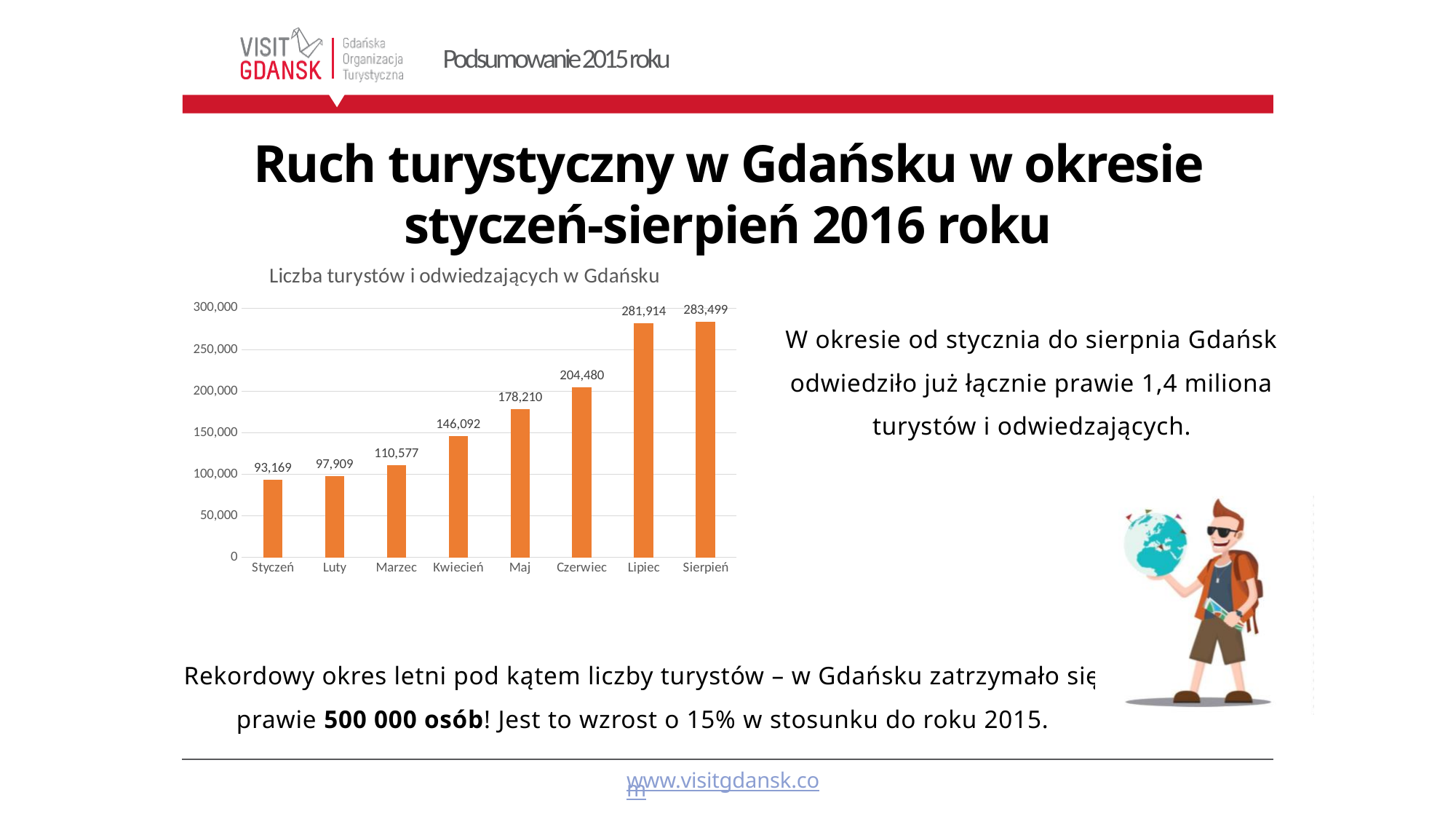
Which is larger, the value for Marzec or the value for Luty? Marzec Which month has the highest value in the chart? Sierpień What is the value for Maj in the chart? 178,210 What is the difference between the values for Czerwiec and Maj? 26,270 Which month has the lowest value in the chart? Styczeń What is the value for Kwiecień? 146,092 What is the title of the chart? Liczba turystów i odwiedzających w Gdańsku How many tourists and visitors does the chart show for Lipiec? 281,914 What kind of chart is shown on the slide? bar chart What is the difference between the values for Sierpień and Lipiec? 1,585 Is the value for Czerwiec greater or less than 200,000? greater How many months are shown on the x axis of the chart? 8